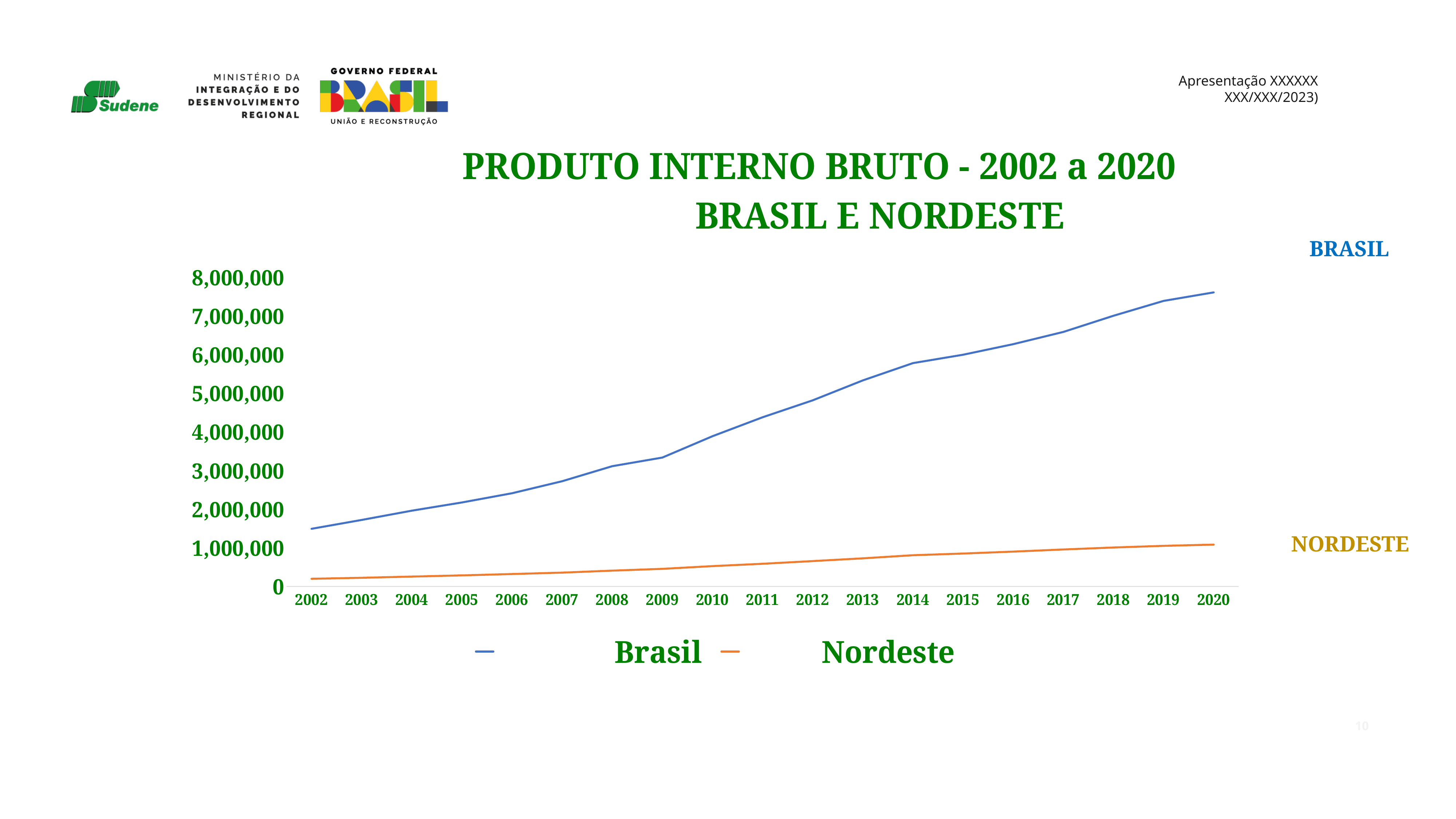
How many series does the legend list? 2 Is the value for Brasil in 2020 greater or less than 7,000,000? greater What kind of chart is shown on the slide? line chart In 2020, which series has the larger value, Brasil or Nordeste? Brasil How many years are plotted along the x axis? 19 Does the Brasil series rise or fall from 2002 to 2020? rise Which series is drawn in orange? Nordeste What is the title of the chart? PRODUTO INTERNO BRUTO - 2002 a 2020 BRASIL E NORDESTE Is the value for Brasil in 2002 greater or less than 2,000,000? less In which year is the Nordeste series at its lowest? 2002 In which year is the Brasil series at its highest? 2020 Is the value for Nordeste in 2002 greater or less than 1,000,000? less